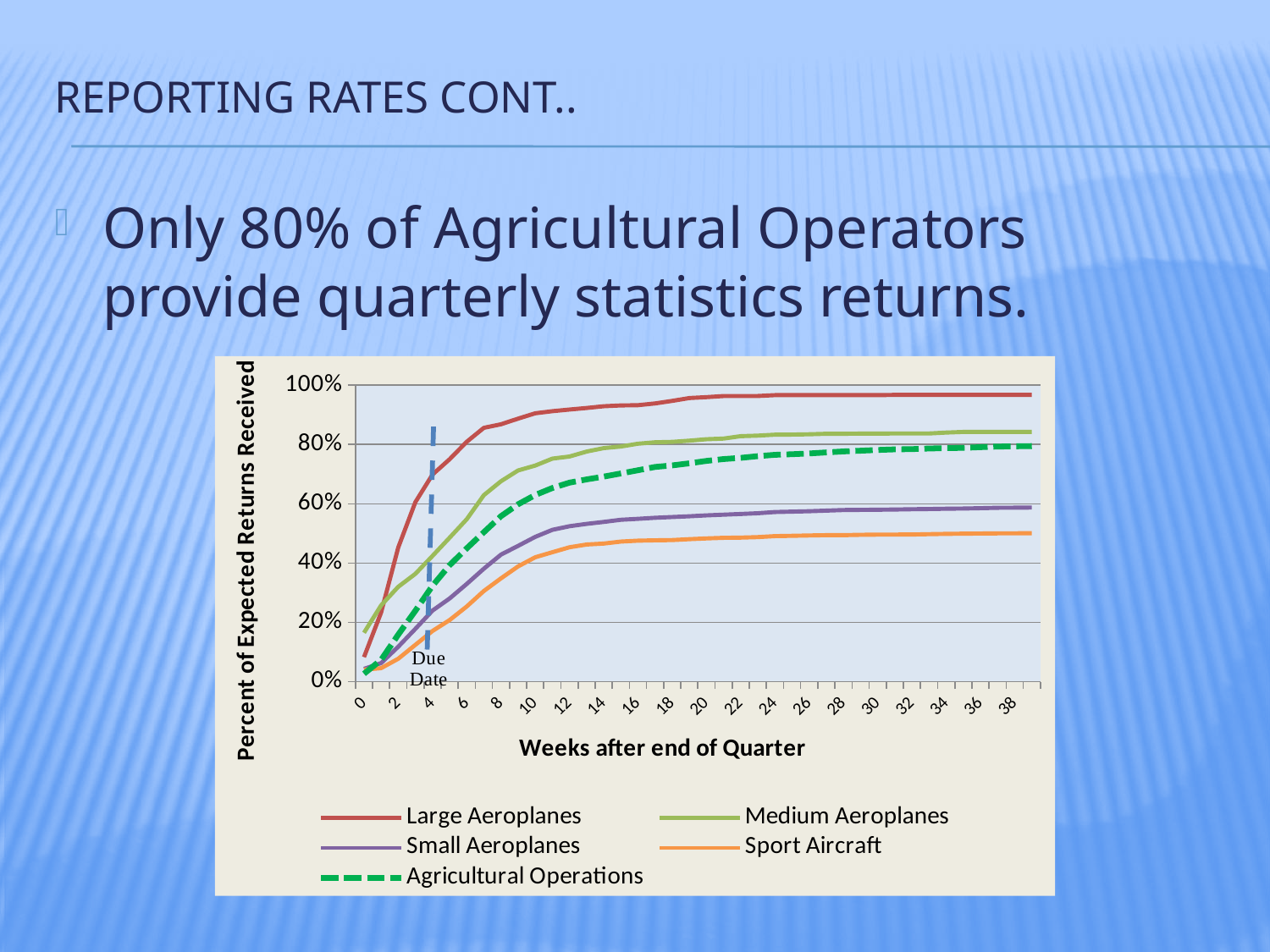
Is the value for Small Aeroplanes at week 38 greater or less than 40%? greater What is the title of the x axis? Weeks after end of Quarter How many series does the legend list? 5 Is the value for Agricultural Operations at week 10 greater or less than 40%? greater Is the value for Large Aeroplanes at week 38 greater or less than 80%? greater What kind of chart is shown on the slide? line chart Which series has the highest value at week 38? Large Aeroplanes Which series has the lowest value at week 38? Sport Aircraft Which series is drawn as a dashed line? Agricultural Operations At week 20, which is larger: Large Aeroplanes or Sport Aircraft? Large Aeroplanes Do the values for each series rise or fall as the weeks after end of quarter increase? rise